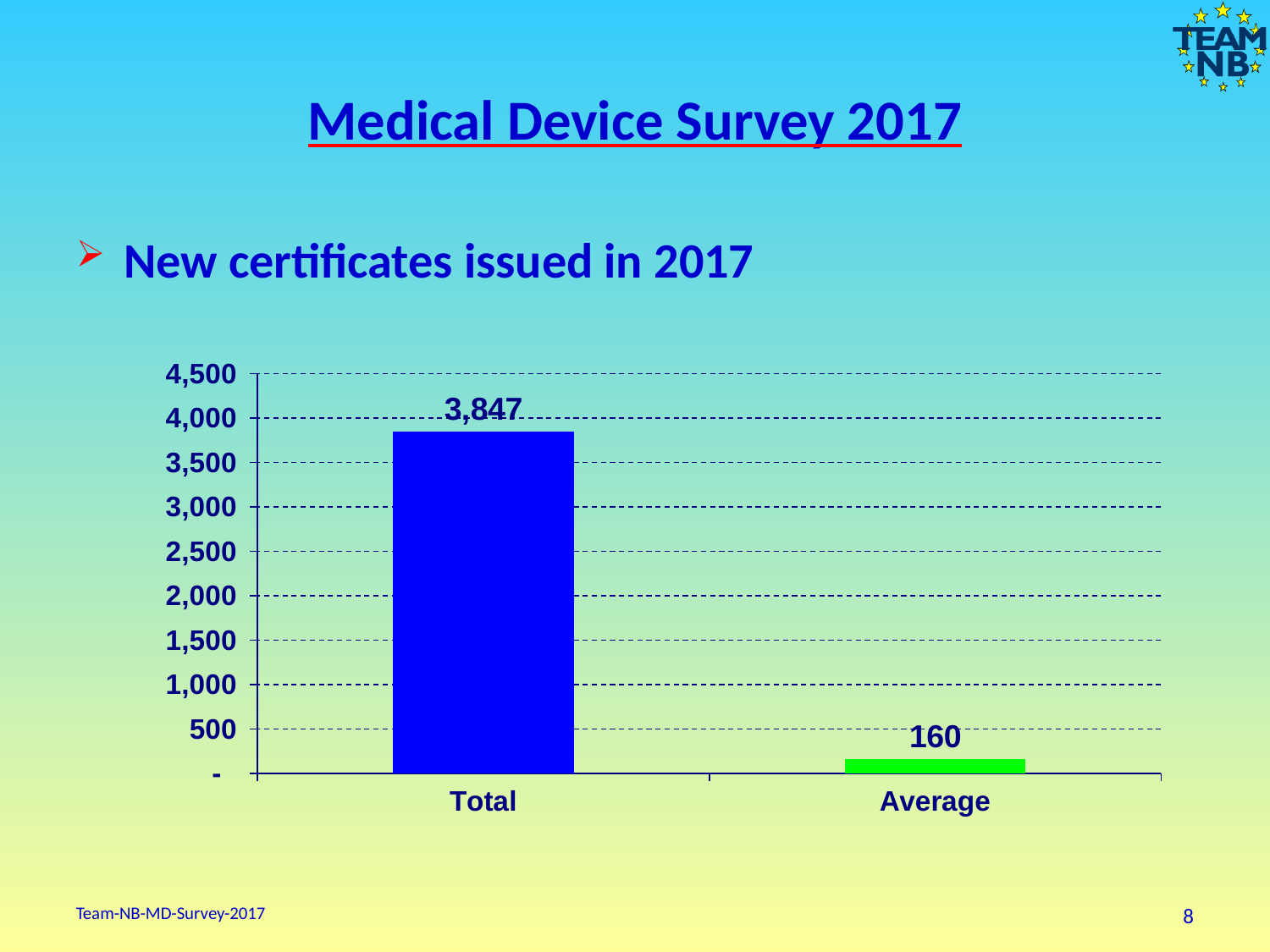
What colour is the Average bar? Green Which is larger, the Total value or the Average value? Total What is the difference between the Total and Average values? 3,687 Which category has the lowest value? Average What is the maximum value shown on the y axis? 4,500 Is the value for Total greater or less than 3,500? greater What is the value of the Average bar? 160 What kind of chart is shown on the slide? Bar chart Which category has the highest value? Total What is the value of the Total bar? 3,847 How many categories are shown on the x axis? 2 Is the value for Average greater or less than 500? less